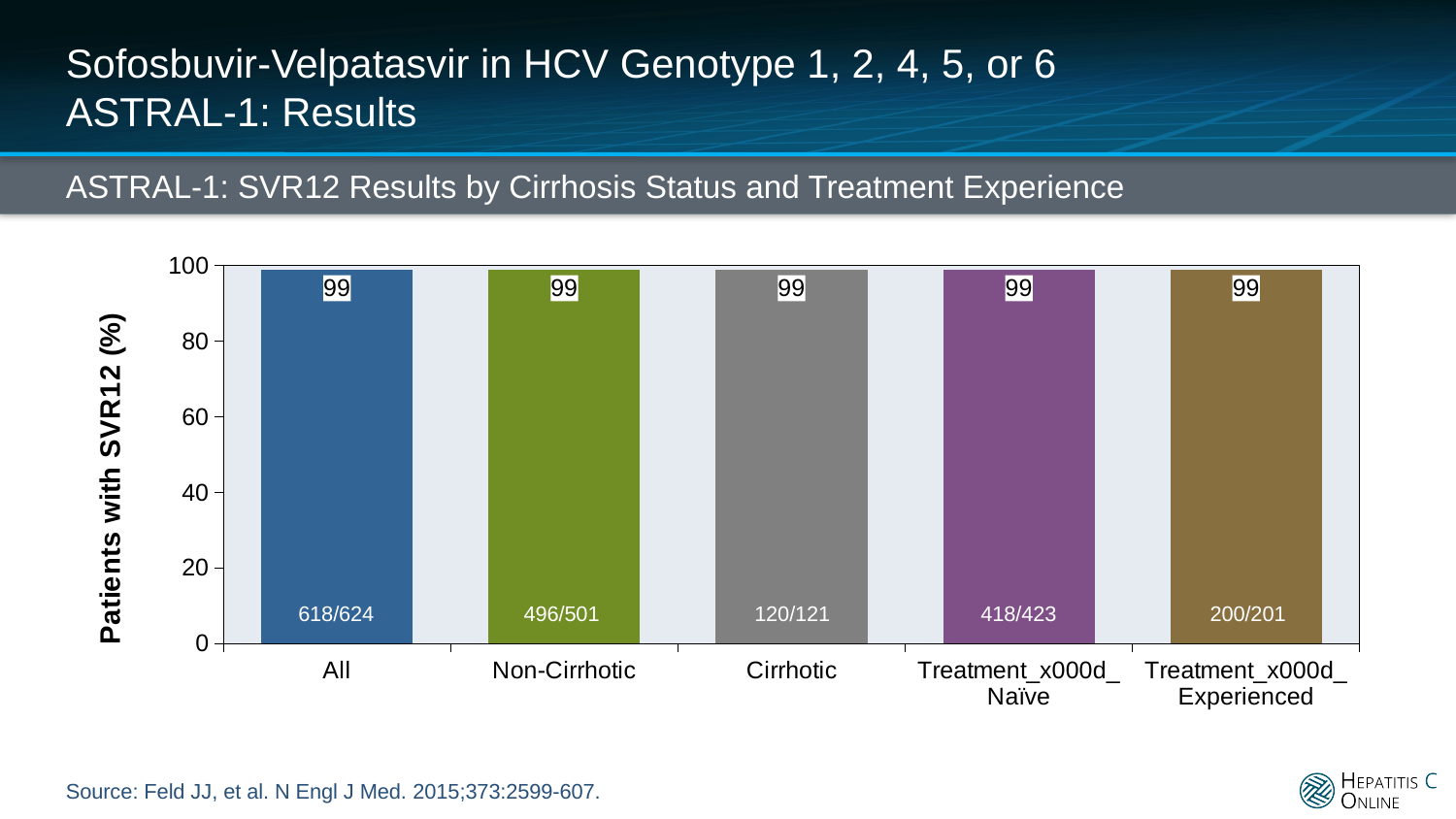
What is the label on the y axis of the chart? Patients with SVR12 (%) Is the value for the Cirrhotic group greater or less than 80? greater How many categories are shown on the x axis of the chart? 5 What fraction of patients is printed on the Treatment Experienced bar? 200/201 What fraction of patients is printed on the Cirrhotic bar? 120/121 Do the values rise, fall, or stay the same across the categories from left to right? stay the same What is the SVR12 percentage for the All group? 99 What kind of chart is shown on the slide? bar chart What fraction of patients is printed on the Non-Cirrhotic bar? 496/501 What is the SVR12 percentage for the Cirrhotic group? 99 What is the difference between the SVR12 percentage for Non-Cirrhotic and Cirrhotic patients? 0 What fraction of patients is printed on the Treatment Naïve bar? 418/423